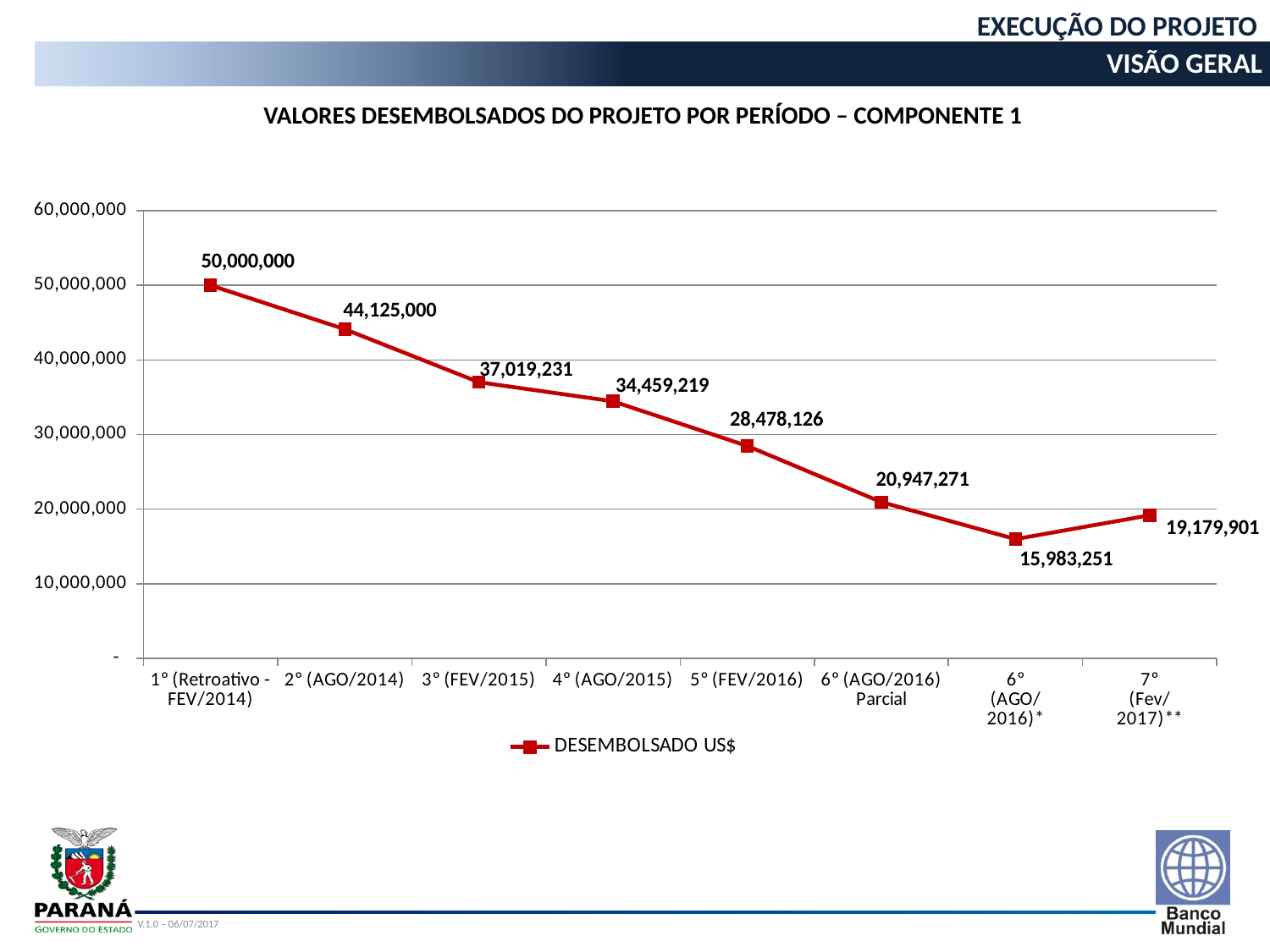
What is the difference between the values for 7° (Fev/2017)** and 6° (AGO/2016)*? 3,196,650 What is the disbursed value for the period 5° (FEV/2016)? 28,478,126 How many periods are plotted on the x axis? 8 What is the difference between the values for 1° (Retroativo - FEV/2014) and 2° (AGO/2014)? 5,875,000 What type of chart is shown on the slide? Line chart Which period has the highest disbursed value? 1° (Retroativo - FEV/2014) Which period has the lowest disbursed value? 6° (AGO/2016)* What is the disbursed value for the period 3° (FEV/2015)? 37,019,231 What is the disbursed value for the period 7° (Fev/2017)**? 19,179,901 Which is larger, the value for 4° (AGO/2015) or the value for 6° (AGO/2016) Parcial? 4° (AGO/2015) What is the overall trend of the disbursed values from 1° (Retroativo - FEV/2014) to 6° (AGO/2016)*? Falling What is the name of the series shown in the legend? DESEMBOLSADO US$